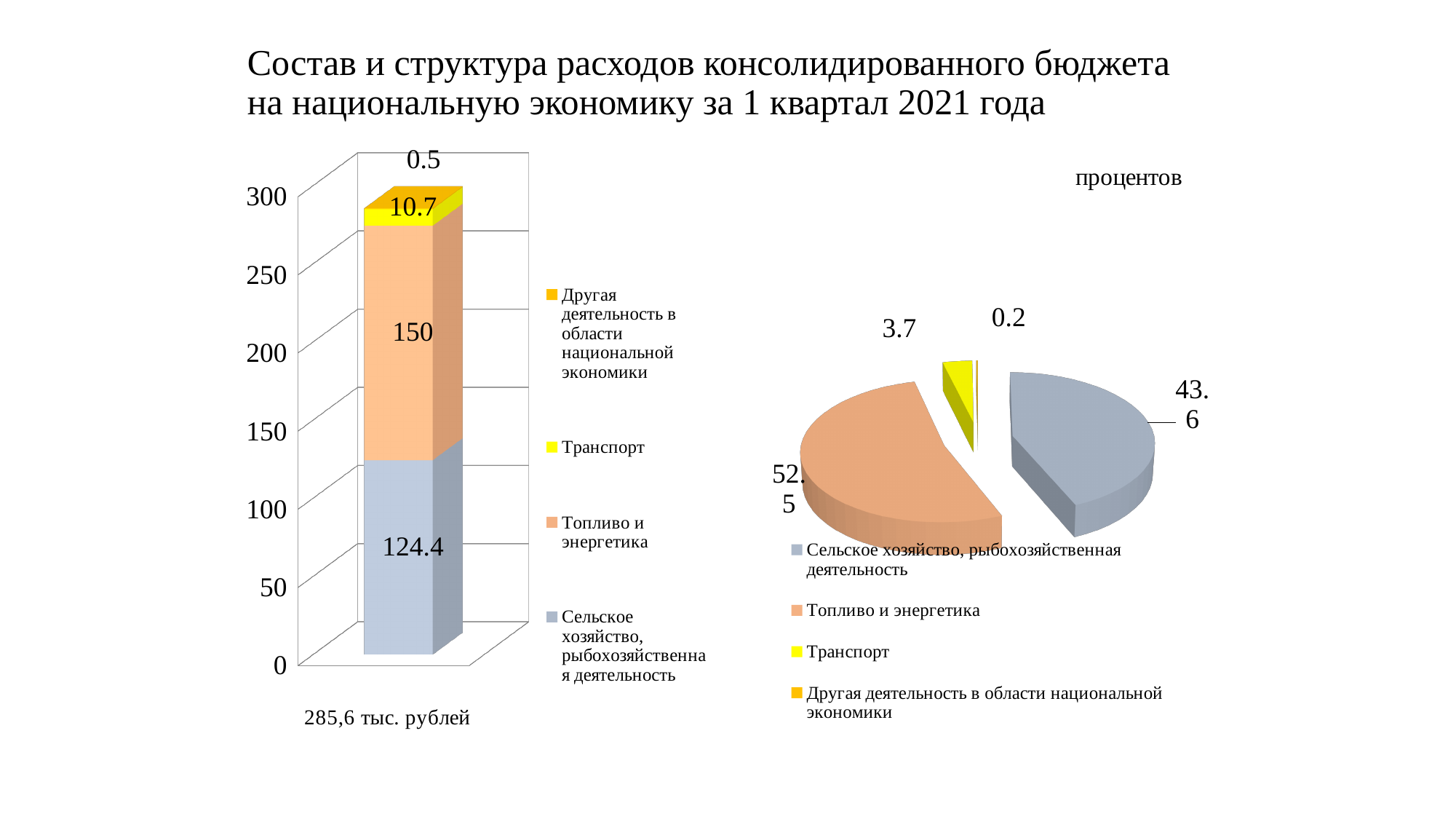
In the pie chart on the right, what is the share for Топливо и энергетика? 52.5 In the stacked bar chart on the left, what is the value for Сельское хозяйство, рыбохозяйственная деятельность? 124.4 In the stacked bar chart on the left, what is the value for Транспорт? 10.7 In the stacked bar chart on the left, which series has the smallest value? Другая деятельность в области национальной экономики In the stacked bar chart on the left, what is the difference between the values for Топливо и энергетика and Сельское хозяйство, рыбохозяйственная деятельность? 25.6 What kind of chart is shown on the right side of the slide? Pie chart In the pie chart on the right, which slice is the largest? Топливо и энергетика In the stacked bar chart on the left, what is the total of all segments in the bar? 285.6 In the pie chart on the right, which is larger: the slice for Транспорт or the slice for Другая деятельность в области национальной экономики? Транспорт In the stacked bar chart on the left, what is the value for Топливо и энергетика? 150 In the pie chart on the right, what is the share for Сельское хозяйство, рыбохозяйственная деятельность? 43.6 How many series does the legend of the stacked bar chart on the left list? 4